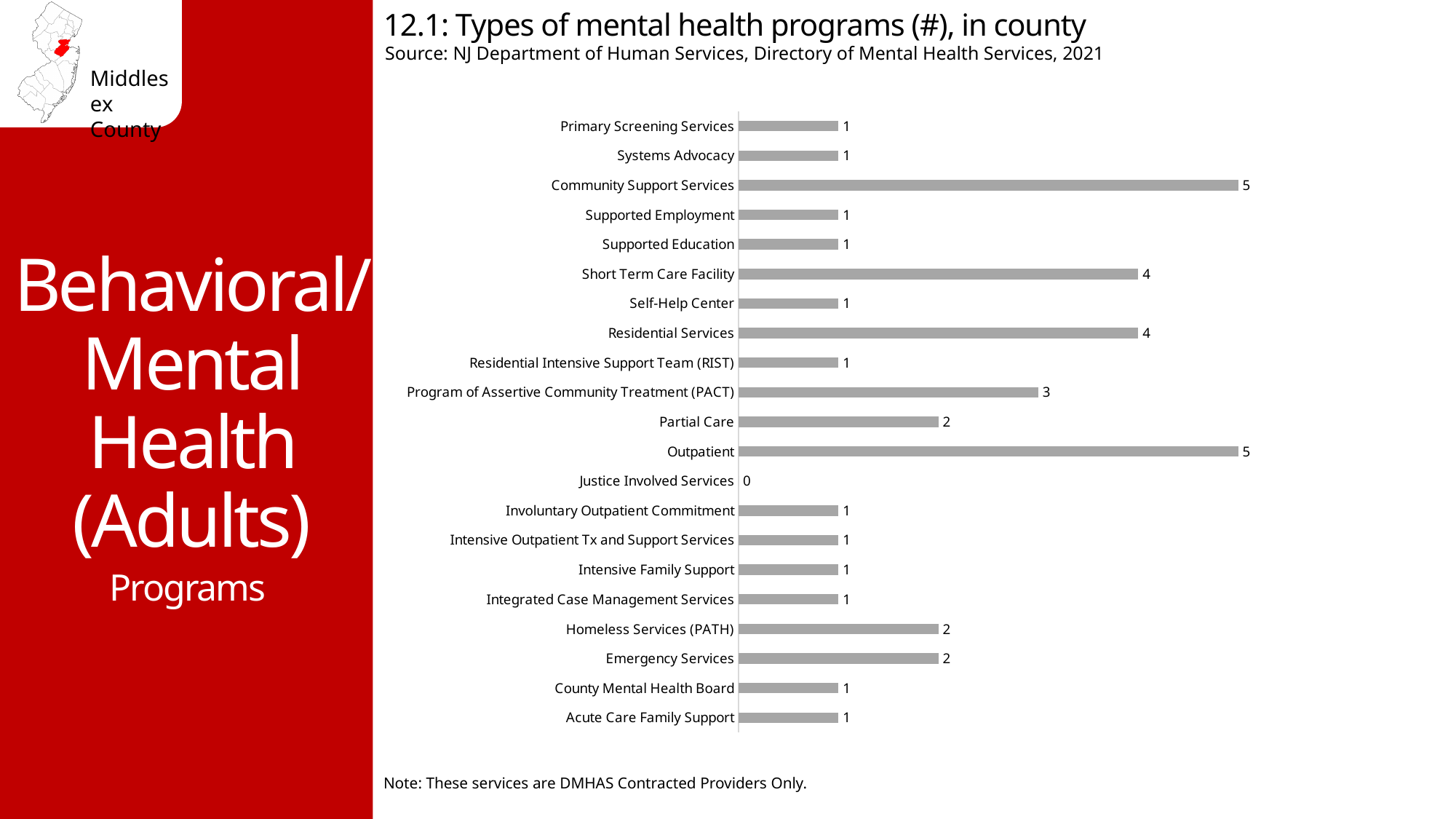
Which has more programs, Residential Services or Homeless Services (PATH)? Residential Services What is the number of Community Support Services programs in the county? 5 Which has a higher value, Emergency Services or Self-Help Center? Emergency Services What is the title of the chart? 12.1: Types of mental health programs (#), in county What is the source cited for the chart data? NJ Department of Human Services, Directory of Mental Health Services, 2021 Which program type has the lowest value on the chart? Justice Involved Services How many Short Term Care Facility programs are shown on the chart? 4 What value is shown for Program of Assertive Community Treatment (PACT)? 3 What is the difference between the number of Outpatient programs and the number of Partial Care programs? 3 What is the value for Justice Involved Services? 0 How many program types (categories) are listed on the chart? 21 What kind of chart is used on this slide? Bar chart